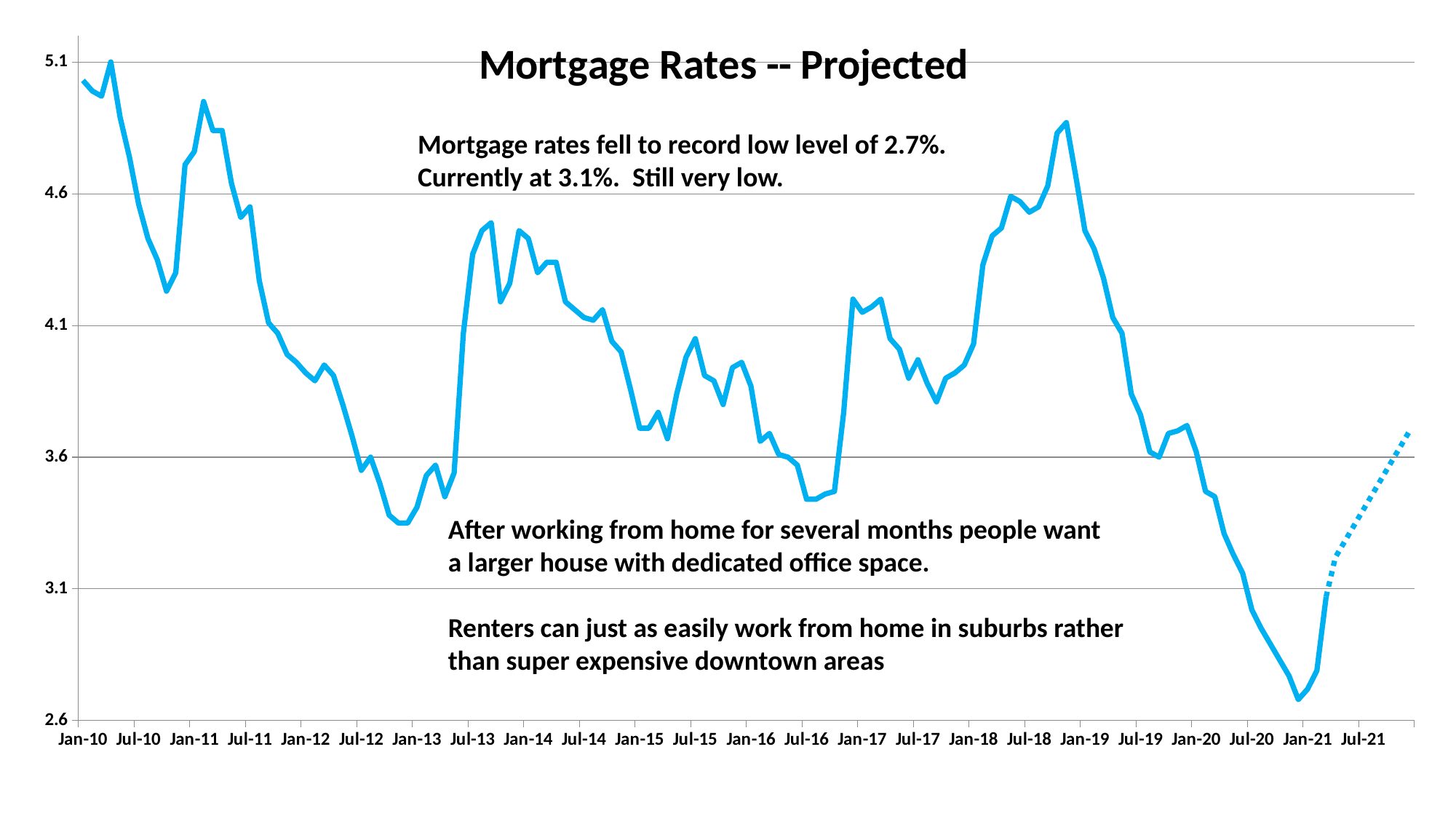
Is the value at Jan-21 greater or less than 3.1? less How many labels are shown on the x axis of the chart? 24 Is the value at Jul-16 greater or less than 3.6? less What kind of chart is shown on the slide? line chart Near which x-axis label does the line reach its lowest point? Jan-21 Is the value at Jan-10 greater or less than 4.6? greater Does the line rise or fall between Jan-19 and Jan-21? fall What is the title of the chart? Mortgage Rates -- Projected Which is larger, the value at Jan-10 or the value at Jan-21? Jan-10